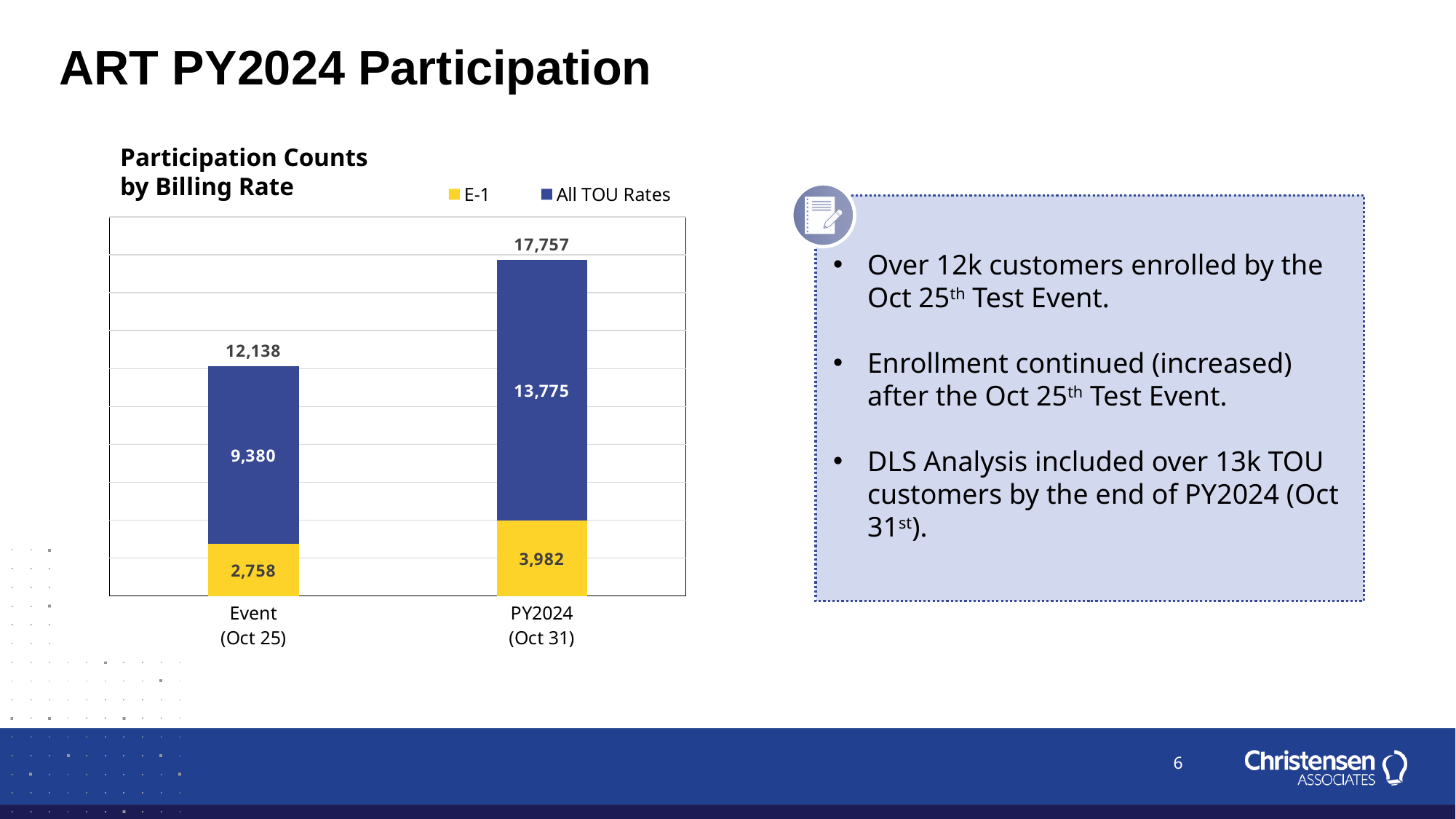
What kind of chart is shown? Stacked bar chart What is the E-1 value for Event (Oct 25)? 2,758 What is the difference between the All TOU Rates values for PY2024 (Oct 31) and Event (Oct 25)? 4,395 Which is larger for Event (Oct 25): the E-1 value or the All TOU Rates value? All TOU Rates Which category has the higher total participation count? PY2024 (Oct 31) What is the difference between the E-1 values for PY2024 (Oct 31) and Event (Oct 25)? 1,224 What is the All TOU Rates value for Event (Oct 25)? 9,380 What is the All TOU Rates value for PY2024 (Oct 31)? 13,775 What is the total of the stacked bar for PY2024 (Oct 31)? 17,757 How many series does the legend list? 2 How many categories are shown on the x axis? 2 What is the total of the stacked bar for Event (Oct 25)? 12,138